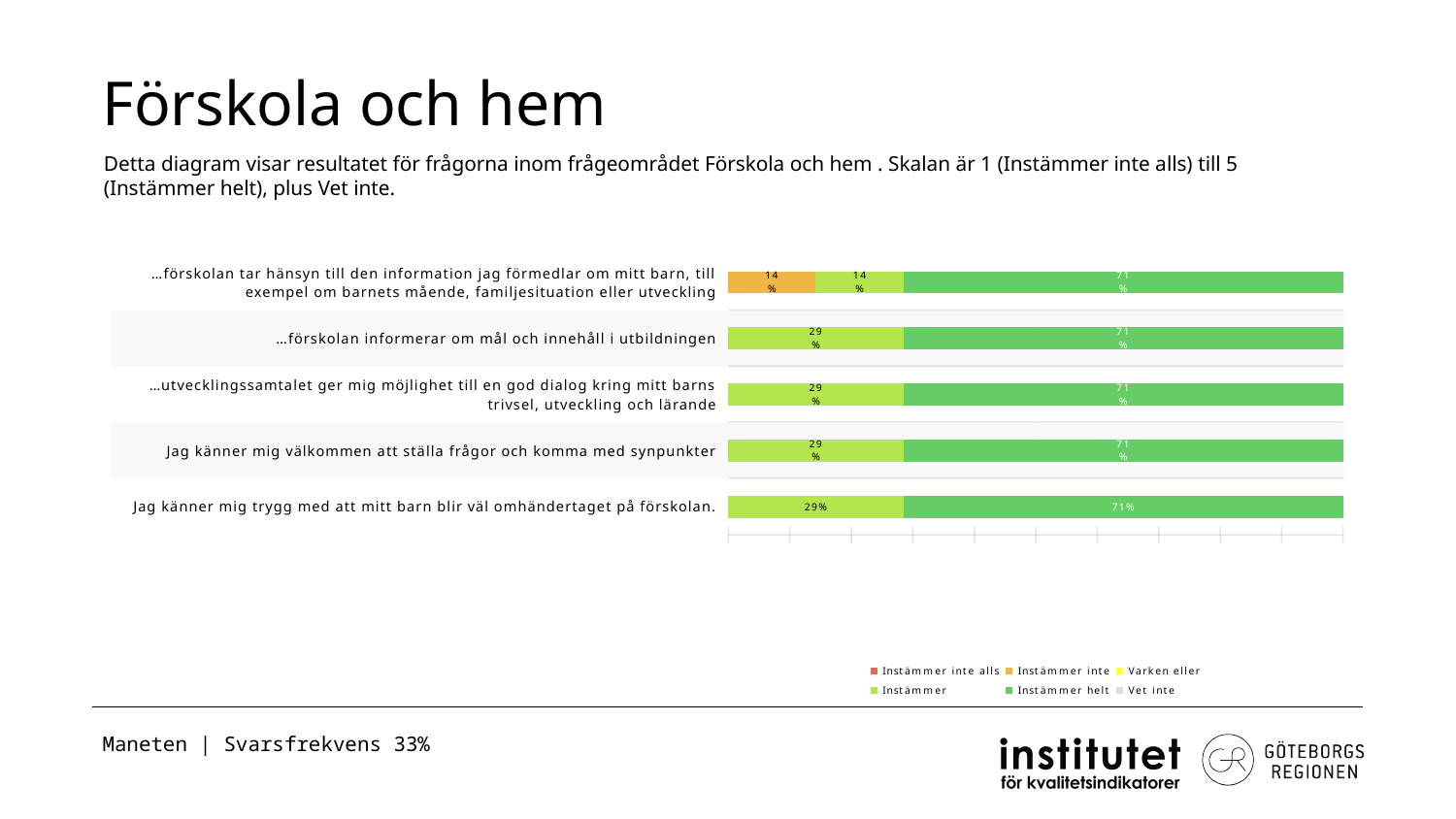
What is the value for "Instämmer inte" for "…förskolan tar hänsyn till den information jag förmedlar om mitt barn, till exempel om barnets mående, familjesituation eller utveckling"? 14% What is the value for "Instämmer" for "Jag känner mig trygg med att mitt barn blir väl omhändertaget på förskolan."? 29% How many series does the legend list? 6 How many categories (statements) are plotted in the chart? 5 Which is larger for "…utvecklingssamtalet ger mig möjlighet till en god dialog kring mitt barns trivsel, utveckling och lärande": "Instämmer" or "Instämmer helt"? Instämmer helt What is the value for "Instämmer helt" for "Jag känner mig trygg med att mitt barn blir väl omhändertaget på förskolan."? 71% What is the difference between the "Instämmer helt" and "Instämmer" values for "Jag känner mig välkommen att ställa frågor och komma med synpunkter"? 42% What is the total of the stacked bar for "…förskolan tar hänsyn till den information jag förmedlar om mitt barn, till exempel om barnets mående, familjesituation eller utveckling"? 99% Which statement has the lowest "Instämmer" value? …förskolan tar hänsyn till den information jag förmedlar om mitt barn, till exempel om barnets mående, familjesituation eller utveckling Which legend entry is shown in dark green? Instämmer helt What is the value for "Instämmer" for "…förskolan informerar om mål och innehåll i utbildningen"? 29% What kind of chart is shown on the slide? stacked bar chart